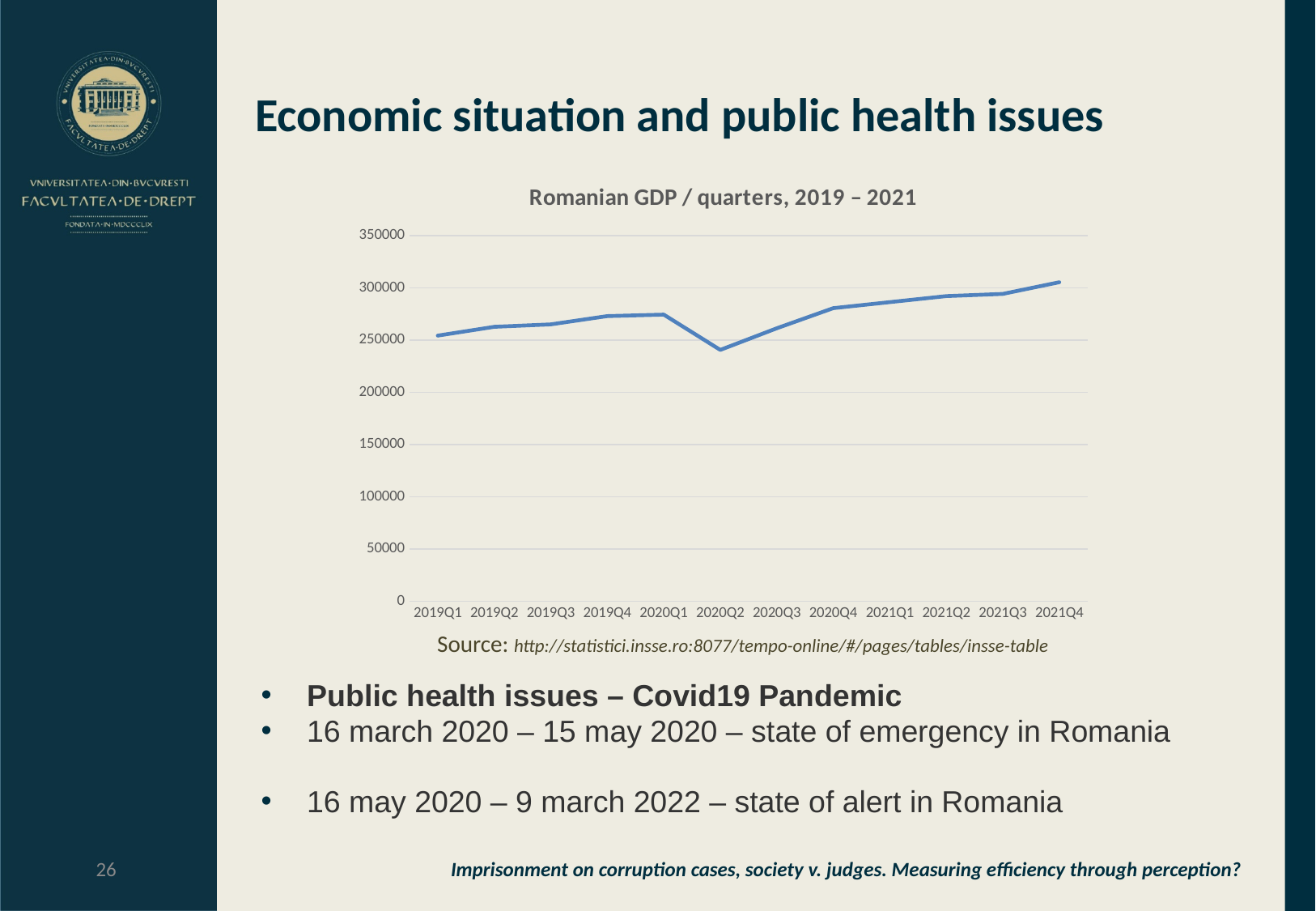
How many quarters are plotted on the x axis of the chart? 12 Which quarter has the lowest GDP value in the chart? 2020Q2 Is the value for 2020Q4 greater or less than 300000? less Which is larger, the value for 2020Q1 or the value for 2020Q2? 2020Q1 Is the value for 2020Q2 greater or less than 250000? less Do the values rise or fall from 2020Q2 to 2021Q4? rise Which quarter has the highest GDP value in the chart? 2021Q4 Is the value for 2021Q4 greater or less than 300000? greater What kind of chart is shown on the slide? line chart Which is larger, the value for 2019Q1 or the value for 2021Q1? 2021Q1 What is the title of the chart? Romanian GDP / quarters, 2019 – 2021